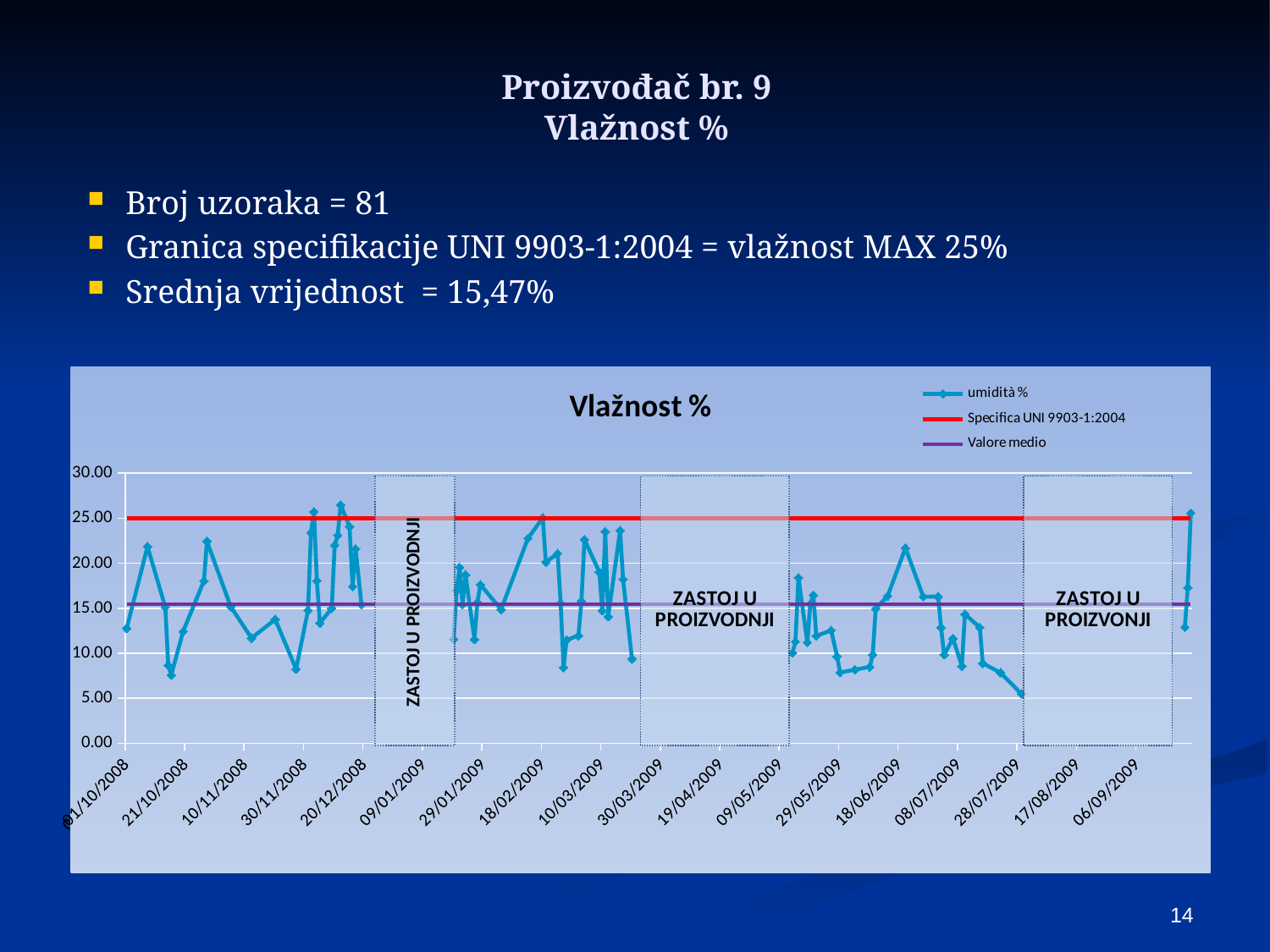
What is the last date label on the x axis? 06/09/2009 Is the highest umidità % value in the chart greater or less than 25? greater What kind of chart is shown on the slide? line chart What is the highest tick value shown on the y axis? 30.00 Which series is drawn in red in the chart? Specifica UNI 9903-1:2004 How many series does the chart legend list? 3 Is the umidità % value for 01/10/2008 greater or less than 15? less Is the lowest umidità % value in the chart greater or less than 10? less What is the first date label on the x axis? 01/10/2008 At what value on the y axis is the Specifica UNI 9903-1:2004 line drawn? 25.00 How many date labels are shown along the x axis? 18 What is the title of the chart? Vlažnost %